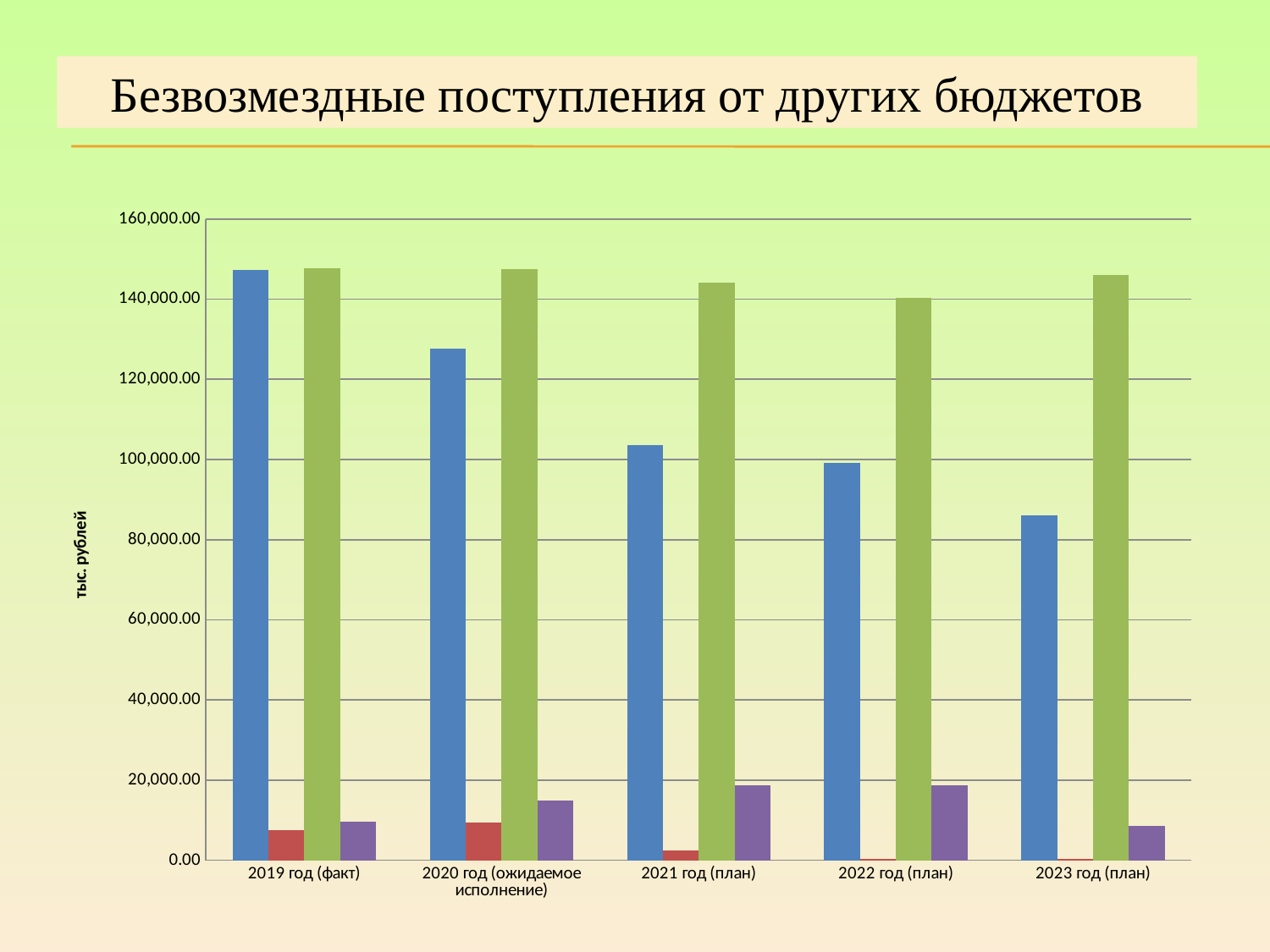
Is the blue bar for 2023 год (план) greater or less than 100,000.00? less Is the purple bar for 2019 год (факт) greater or less than 20,000.00? less Is the green bar for 2022 год (план) greater or less than 120,000.00? greater What is the label on the vertical axis? тыс. рублей Among the blue bars, which category has the highest value? 2019 год (факт) What kind of chart is shown on the slide? bar chart For 2021 год (план), which is larger: the red bar or the purple bar? the purple bar How many categories are shown along the x axis? 5 For 2022 год (план), which is larger: the blue bar or the green bar? the green bar Do the blue bars rise or fall from 2019 год (факт) to 2023 год (план)? fall